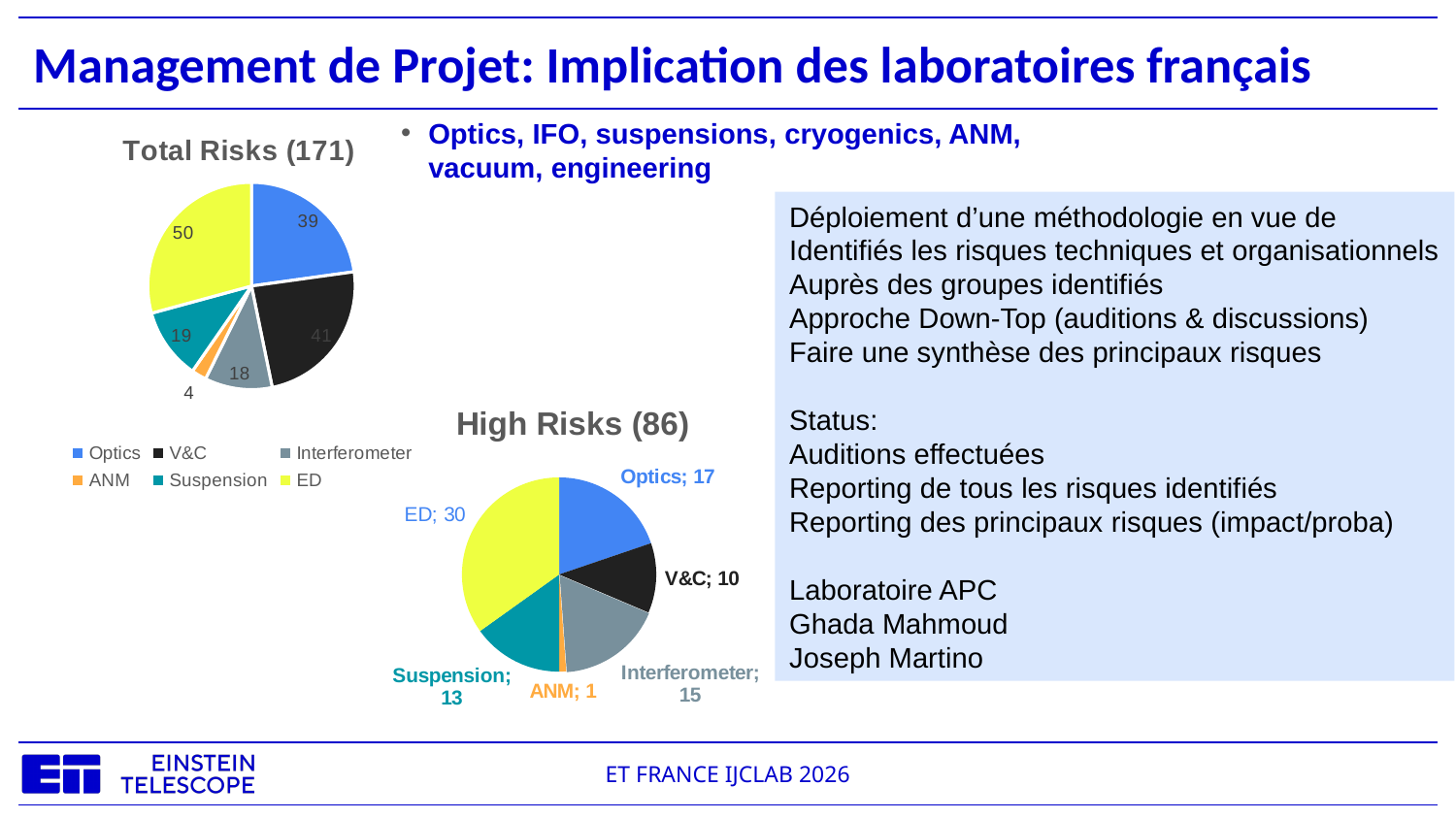
In the Total Risks (171) chart, which is larger, the value for Optics or the value for Suspension? Optics In the Total Risks (171) chart, which category has the largest slice? ED In the Total Risks (171) chart, what is the value for V&C? 41 How many categories does the legend of the Total Risks (171) chart list? 6 In the Total Risks (171) chart, what is the value for ED? 50 In the High Risks (86) chart, which category has the smallest slice? ANM In the High Risks (86) chart, what share of the total does ED represent, as a fraction of 86? 30/86 In the High Risks (86) chart, what is the value for Interferometer? 15 What kind of chart is the High Risks (86) chart? Pie chart In the High Risks (86) chart, what is the value for Suspension? 13 What is the title of the chart in the upper left of the slide? Total Risks (171) In the High Risks (86) chart, what is the difference between the values for ED and Optics? 13